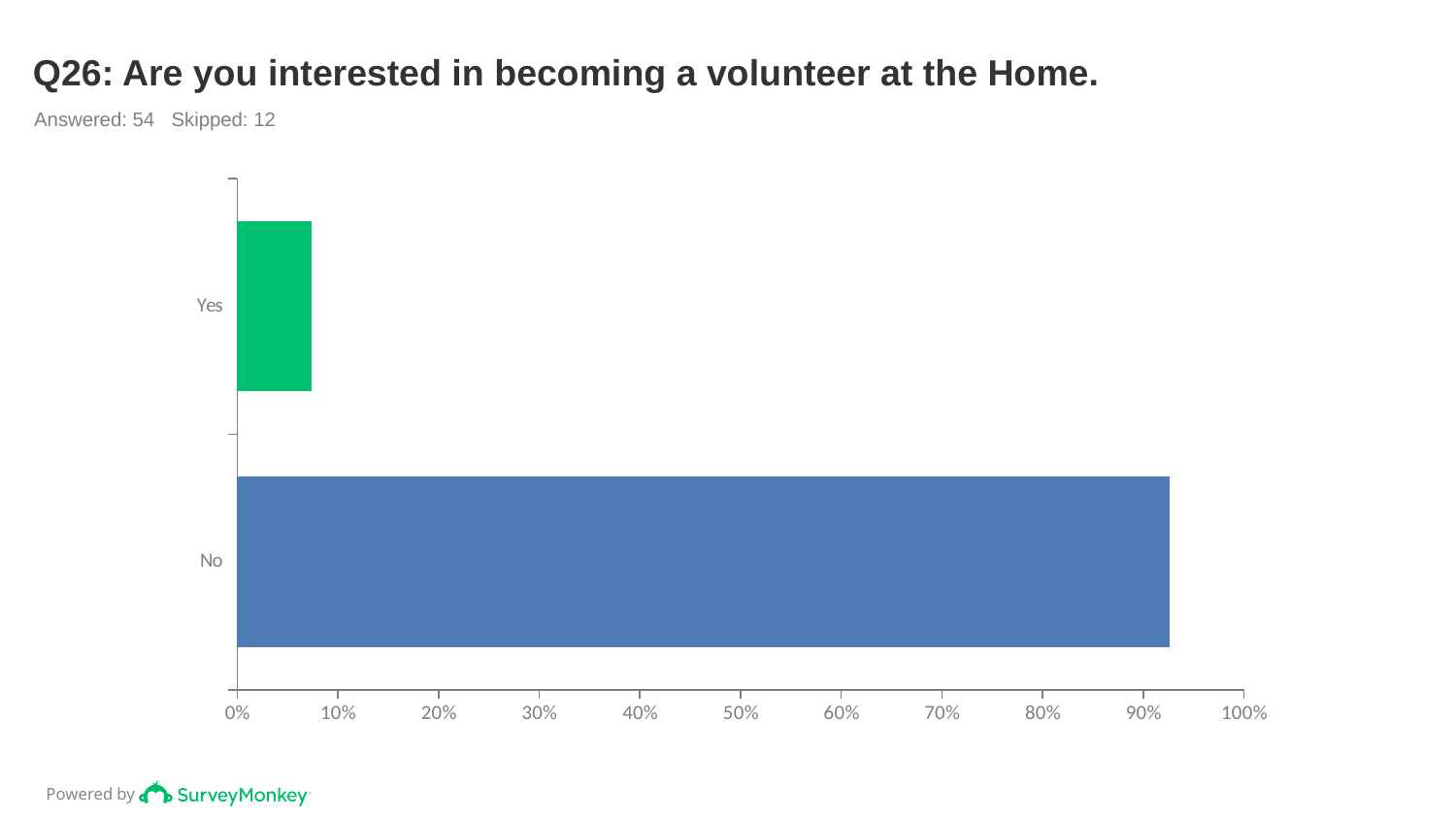
Is the value for No greater or less than 90%? greater Is the value for No greater or less than 50%? greater How many categories are plotted in the chart? 2 Is the value for Yes greater or less than 10%? less What kind of chart is shown on the slide? bar chart What is the title of the chart? Q26: Are you interested in becoming a volunteer at the Home. Which category has the highest value? No Which category has the lowest value? Yes Which is larger, the value for Yes or the value for No? No What colour is the bar for Yes? green